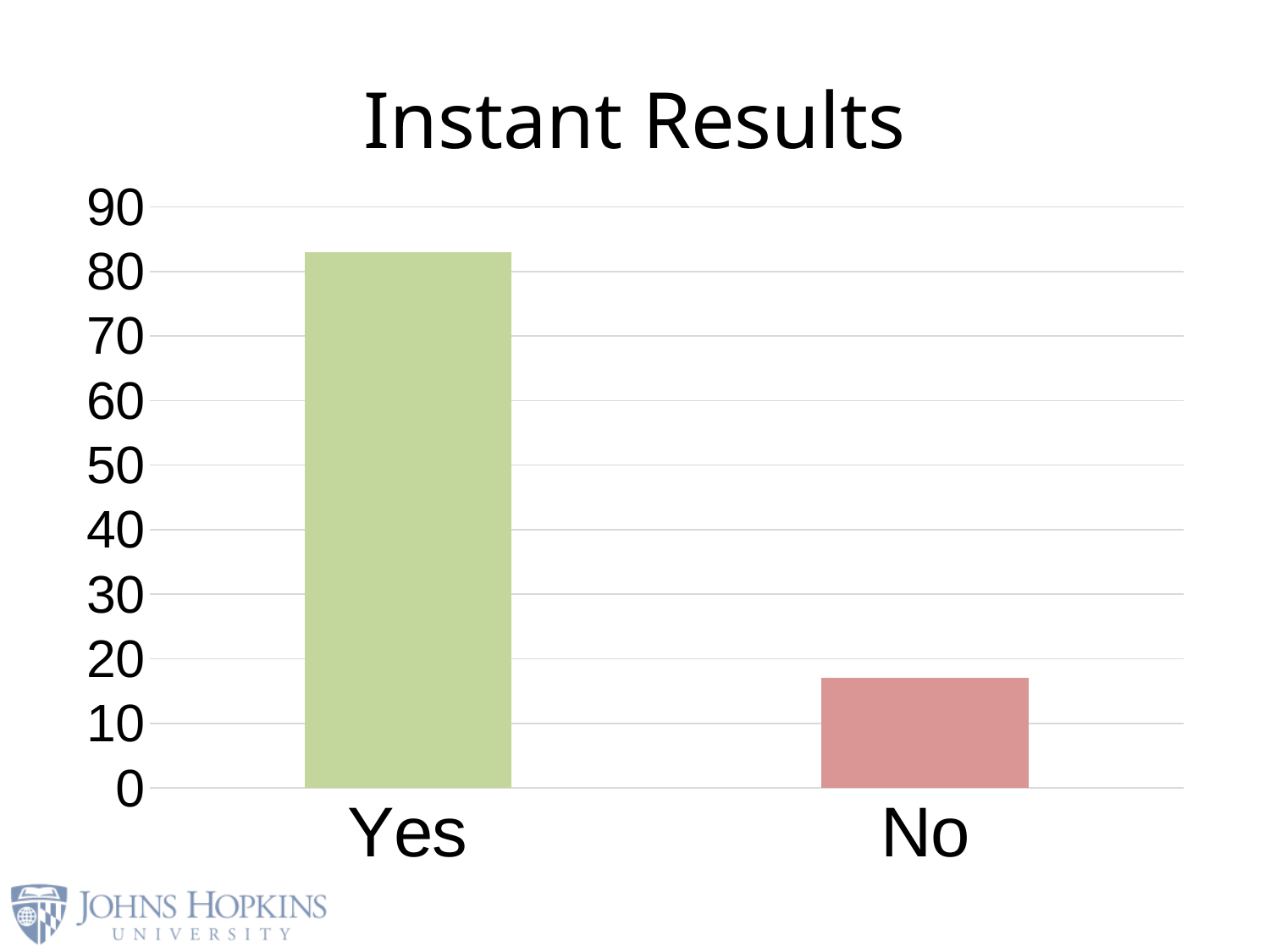
What is the title of the chart? Instant Results Which is larger, the value for Yes or the value for No? Yes How many categories are shown on the x axis? 2 Which category has the highest value? Yes What is the highest value shown on the y axis? 90 Is the value for Yes greater or less than 80? greater Is the value for No greater or less than 20? less What kind of chart is shown on the slide? bar chart Which category has the lowest value? No What colour is the bar for Yes? green Is the value for No greater or less than 10? greater